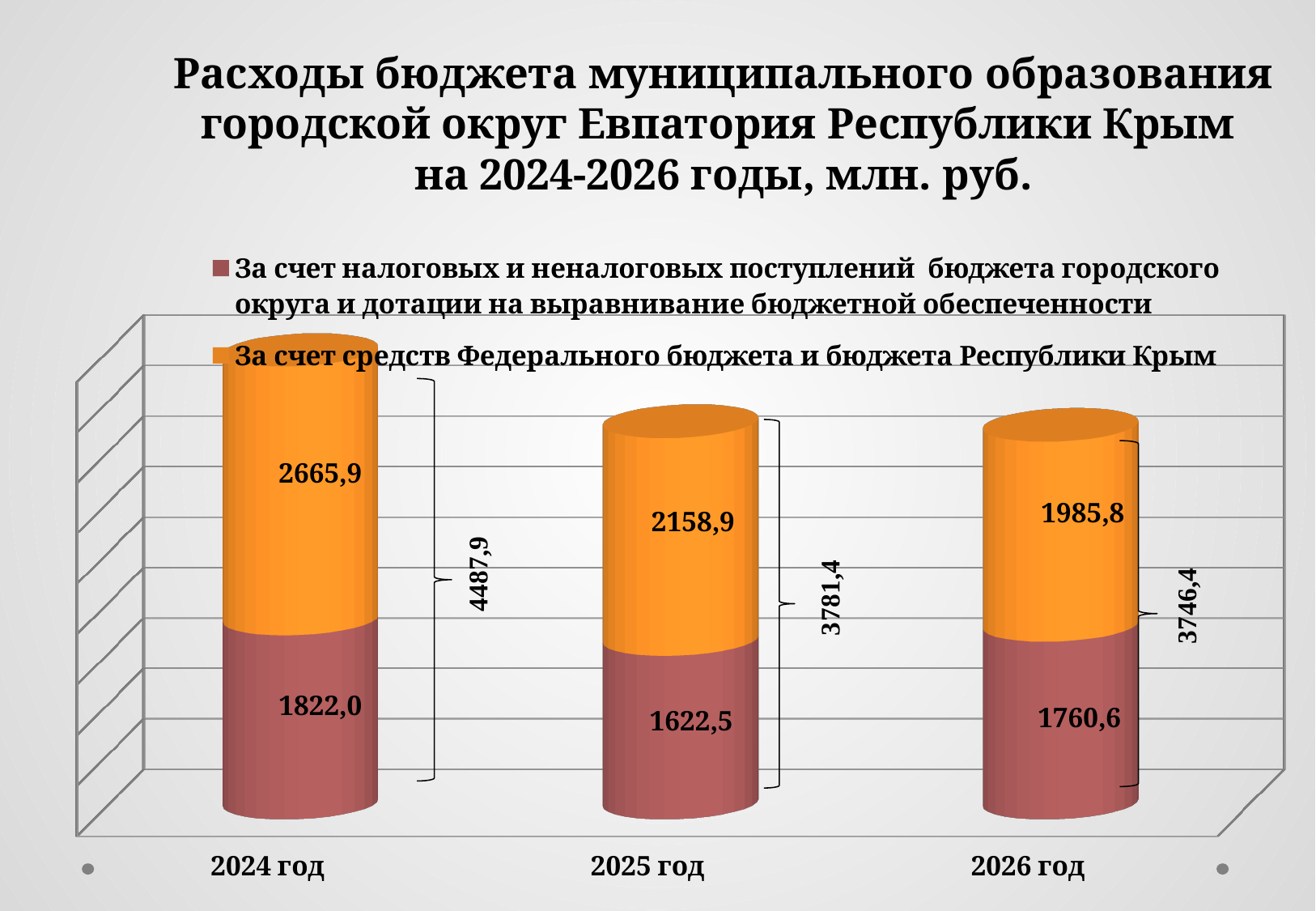
Which year has the lowest value for 'За счет налоговых и неналоговых поступлений бюджета городского округа и дотации на выравнивание бюджетной обеспеченности'? 2025 год How many series does the legend list? 2 What is the difference between the 'За счет средств Федерального бюджета и бюджета Республики Крым' values for 2024 год and 2025 год? 507,0 What is the total of the stacked bar for 2026 год? 3746,4 What is the value for 'За счет средств Федерального бюджета и бюджета Республики Крым' in 2024 год? 2665,9 How many years (categories) are shown on the chart? 3 Which is larger: the 'За счет средств Федерального бюджета и бюджета Республики Крым' value in 2025 год or in 2026 год? 2025 год Do the total expenditures rise or fall from 2024 год to 2026 год? fall What is the value for 'За счет налоговых и неналоговых поступлений бюджета городского округа и дотации на выравнивание бюджетной обеспеченности' in 2025 год? 1622,5 Which year has the highest total expenditure? 2024 год What is the total of the stacked bar for 2024 год? 4487,9 What is the value for 'За счет средств Федерального бюджета и бюджета Республики Крым' in 2026 год? 1985,8